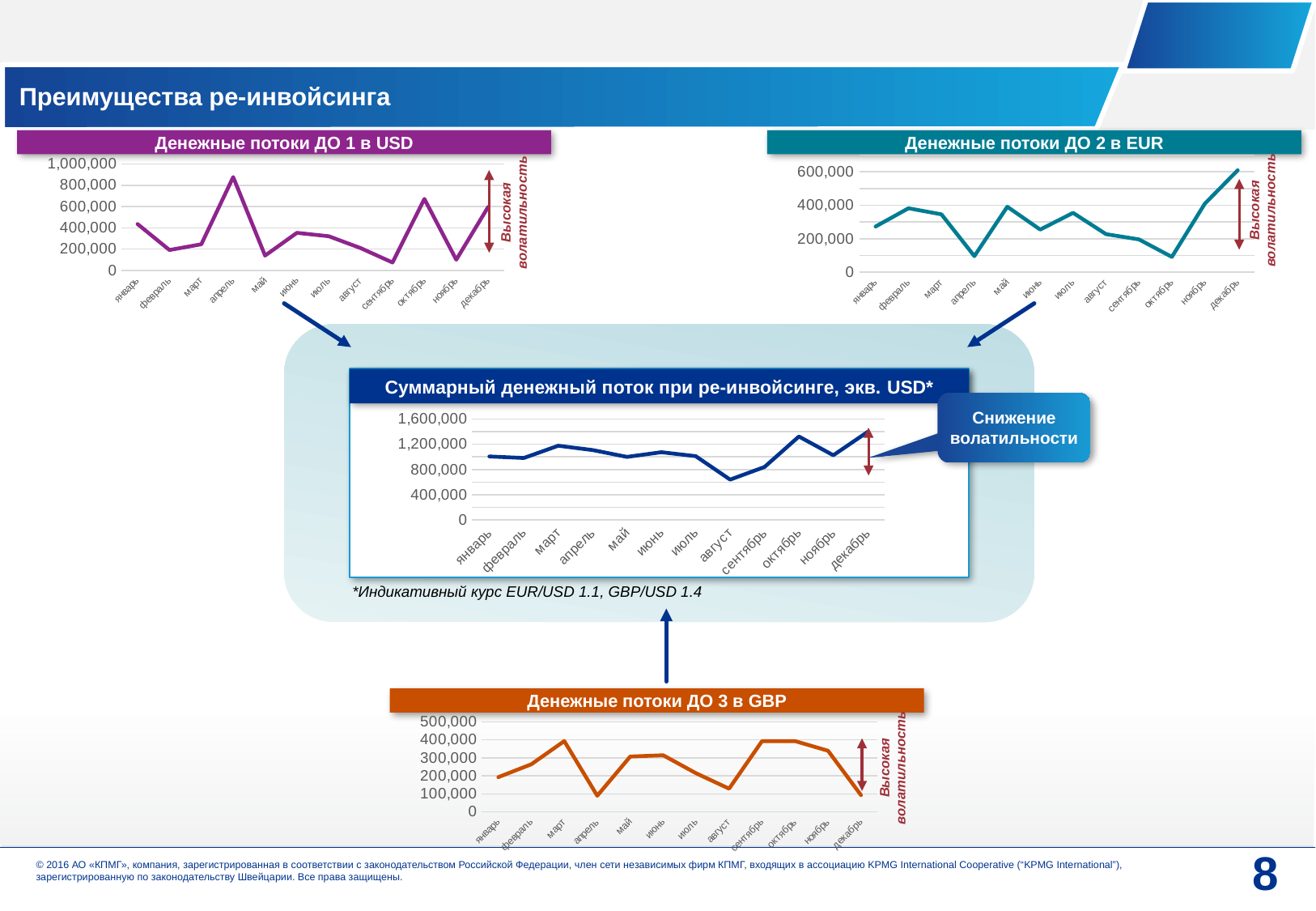
In the 'Денежные потоки ДО 3 в GBP' chart, is the value for март greater or less than 300,000? greater In the 'Денежные потоки ДО 1 в USD' chart, which month has the highest value? апрель In the 'Денежные потоки ДО 2 в EUR' chart, is the value for апрель greater or less than 200,000? less What is the title of the chart in the centre of the slide? Суммарный денежный поток при ре-инвойсинге, экв. USD* What kind of chart is the 'Денежные потоки ДО 1 в USD' chart? line chart In the 'Денежные потоки ДО 1 в USD' chart, is the value for апрель greater or less than 800,000? greater In the 'Суммарный денежный поток при ре-инвойсинге, экв. USD*' chart, which month has the lowest value? август In the 'Денежные потоки ДО 2 в EUR' chart, which month has the highest value? декабрь How many months are plotted on the x axis of the 'Денежные потоки ДО 2 в EUR' chart? 12